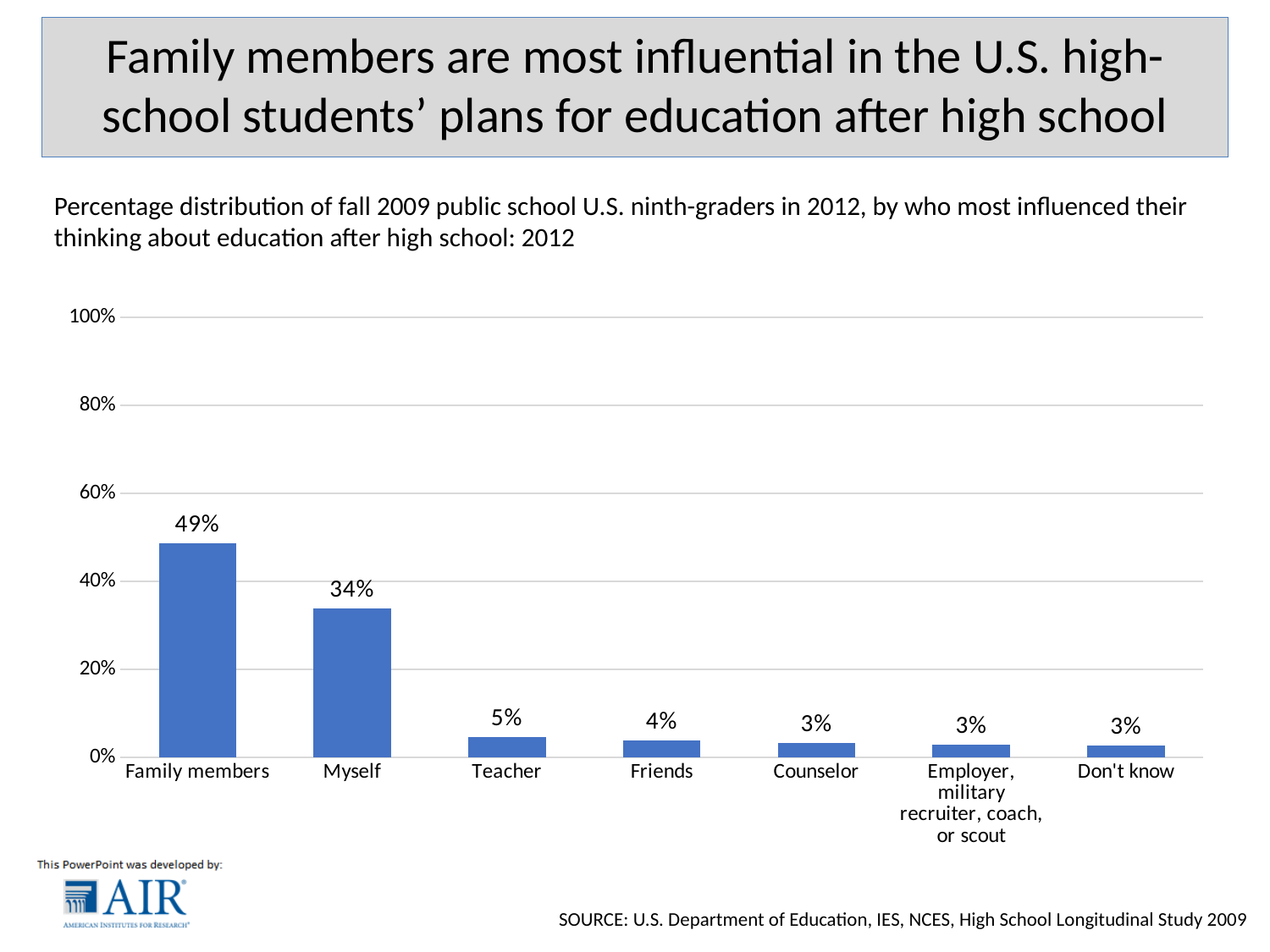
What is the difference between the Family members and Myself percentages? 15% What is the value shown for Myself? 34% What is the value for Friends? 4% How many categories are shown on the x axis? 7 Which category has the highest percentage? Family members What percentage is shown for Teacher? 5% Do the values rise or fall moving from left to right along the x axis? Fall What is the highest value labelled on the y axis? 100% Is the value for Family members greater or less than 40%? greater Which is larger, the value for Teacher or the value for Counselor? Teacher What kind of chart is shown on the slide? Bar chart What percentage of students said family members most influenced their thinking about education after high school? 49%